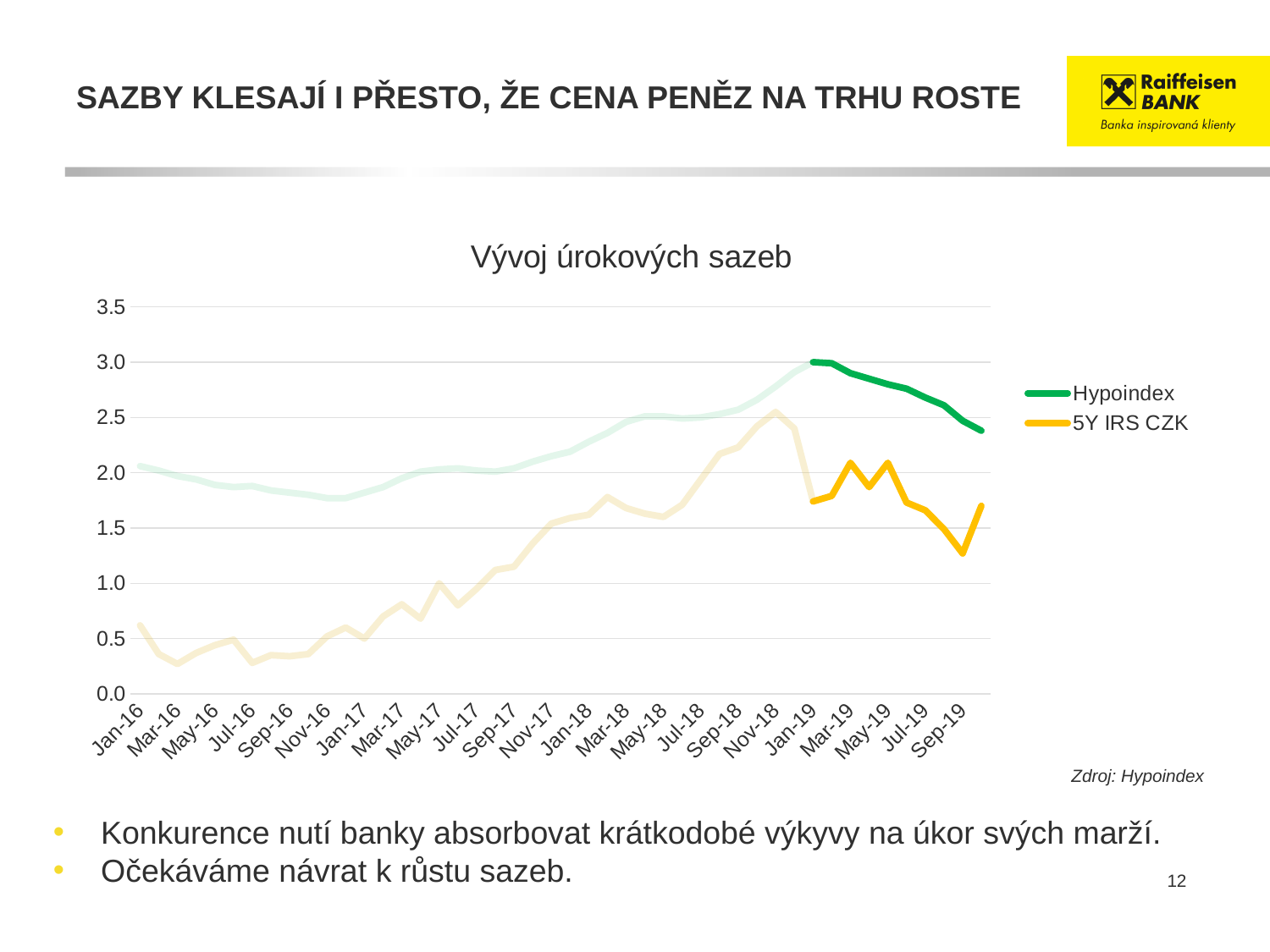
Does the 5Y IRS CZK series rise or fall overall between Jan-16 and Nov-18? rise Which series is drawn in green in the chart? Hypoindex What is the title of the chart? Vývoj úrokových sazeb Which series has the higher value in Jan-16, Hypoindex or 5Y IRS CZK? Hypoindex Which series reaches the lowest value shown on the chart? 5Y IRS CZK Is the value of Hypoindex in Sep-19 greater or less than 2.0? greater Is the value of Hypoindex in Jan-16 greater or less than 1.5? greater What kind of chart is shown on the slide? line chart How many series does the legend list? 2 Does the Hypoindex series rise or fall between Jan-19 and Sep-19? fall Is the value of 5Y IRS CZK in Jan-16 greater or less than 1.0? less